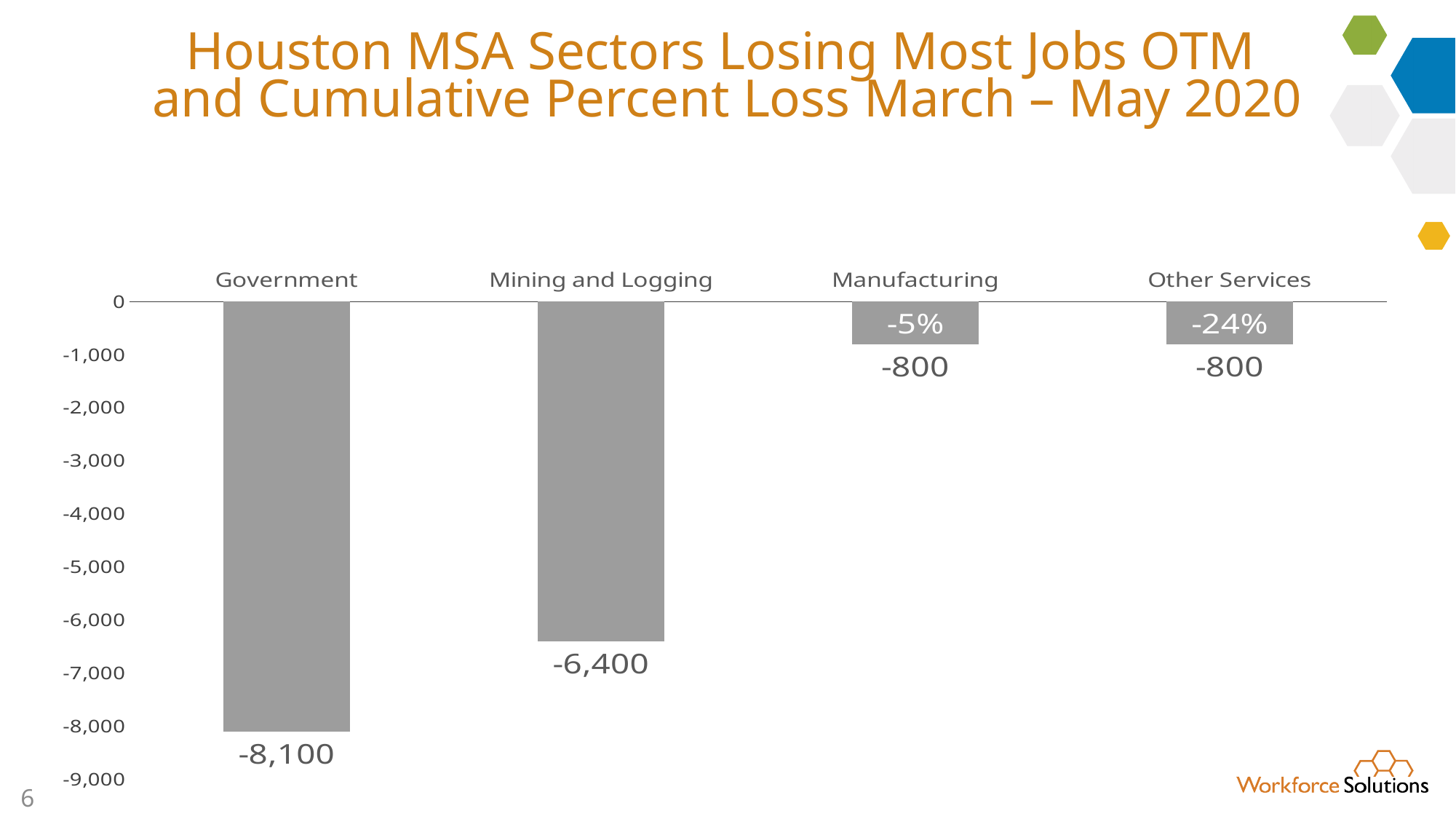
What cumulative percent loss is shown on the Other Services bar? -24% What kind of chart is this? Bar chart What is the difference between the Government and Mining and Logging values? 1,700 What is the title of the slide? Houston MSA Sectors Losing Most Jobs OTM and Cumulative Percent Loss March – May 2020 What is the value for Government? -8,100 What cumulative percent loss is shown on the Manufacturing bar? -5% What is the value for Manufacturing? -800 What is the lowest value shown on the vertical axis? -9,000 What is the value for Mining and Logging? -6,400 Which sector has the largest job loss? Government How many sectors are shown in the chart? 4 Which sector lost more jobs, Mining and Logging or Manufacturing? Mining and Logging